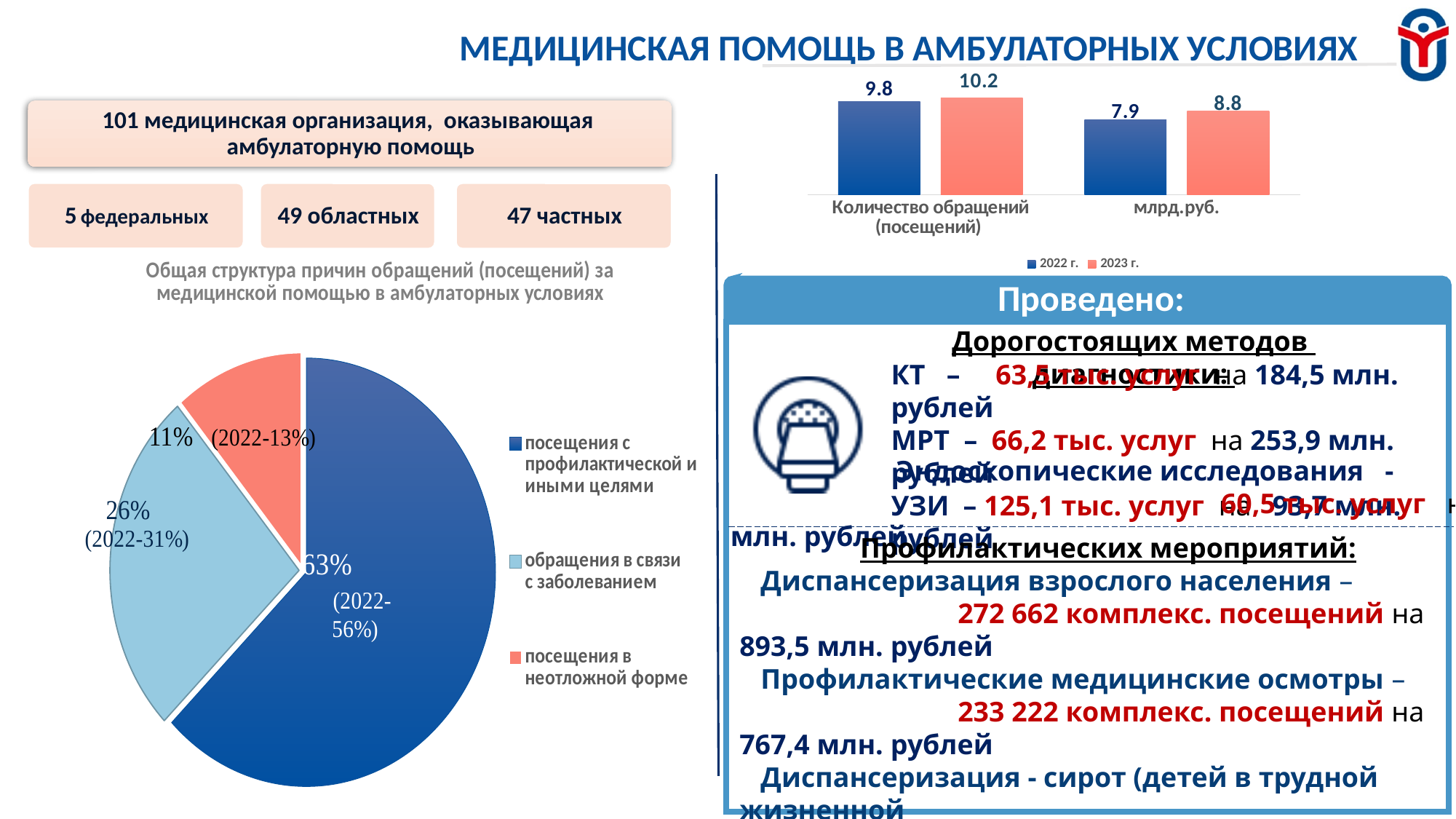
In the pie chart on the left, which category has the smallest slice? посещения в неотложной форме In the pie chart on the left, what share do 'посещения с профилактической и иными целями' have? 63% In the pie chart on the left, how many categories are shown? 3 In the pie chart on the left, what share do 'обращения в связи с заболеванием' have? 26% In the bar chart at the top right, what is the value for 'Количество обращений (посещений)' in 2023? 10.2 In the bar chart at the top right, what is the value for 'млрд.руб.' in 2023? 8.8 In the pie chart on the left, what was the 2022 share for 'посещения в неотложной форме' as shown in parentheses? 13% In the bar chart at the top right, what is the value for 'Количество обращений (посещений)' in 2022? 9.8 In the bar chart at the top right, how many series does the legend list? 2 In the bar chart at the top right, what is the difference between the 2023 and 2022 values for 'млрд.руб.'? 0.9 What kind of chart is shown at the top right of the slide? Bar chart In the bar chart at the top right, which year has the larger value for 'Количество обращений (посещений)', 2022 or 2023? 2023